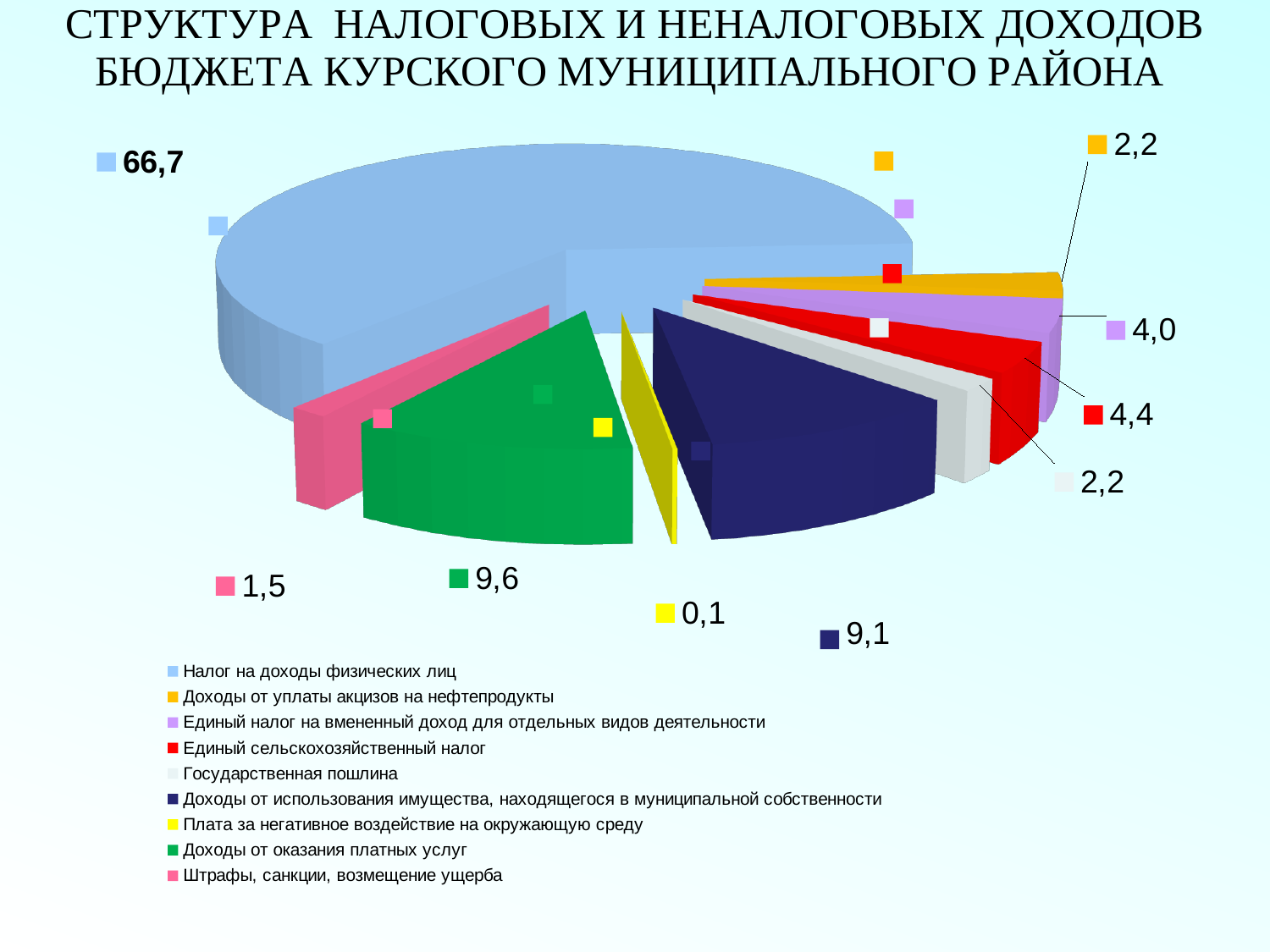
What is the value for "Доходы от оказания платных услуг"? 9,6 What kind of chart is shown on the slide? Pie chart What is the difference between the values for "Доходы от оказания платных услуг" and "Доходы от использования имущества, находящегося в муниципальной собственности"? 0,5 What colour is the slice for "Штрафы, санкции, возмещение ущерба"? Pink Which category has the largest share of the pie? Налог на доходы физических лиц What is the value for "Плата за негативное воздействие на окружающую среду"? 0,1 What is the value for "Доходы от использования имущества, находящегося в муниципальной собственности"? 9,1 Which is larger: the value for "Единый сельскохозяйственный налог" or the value for "Единый налог на вмененный доход для отдельных видов деятельности"? Единый сельскохозяйственный налог Which category has the smallest share of the pie? Плата за негативное воздействие на окружающую среду What is the value for "Единый сельскохозяйственный налог"? 4,4 How many categories does the legend list? 9 What is the value for "Налог на доходы физических лиц"? 66,7